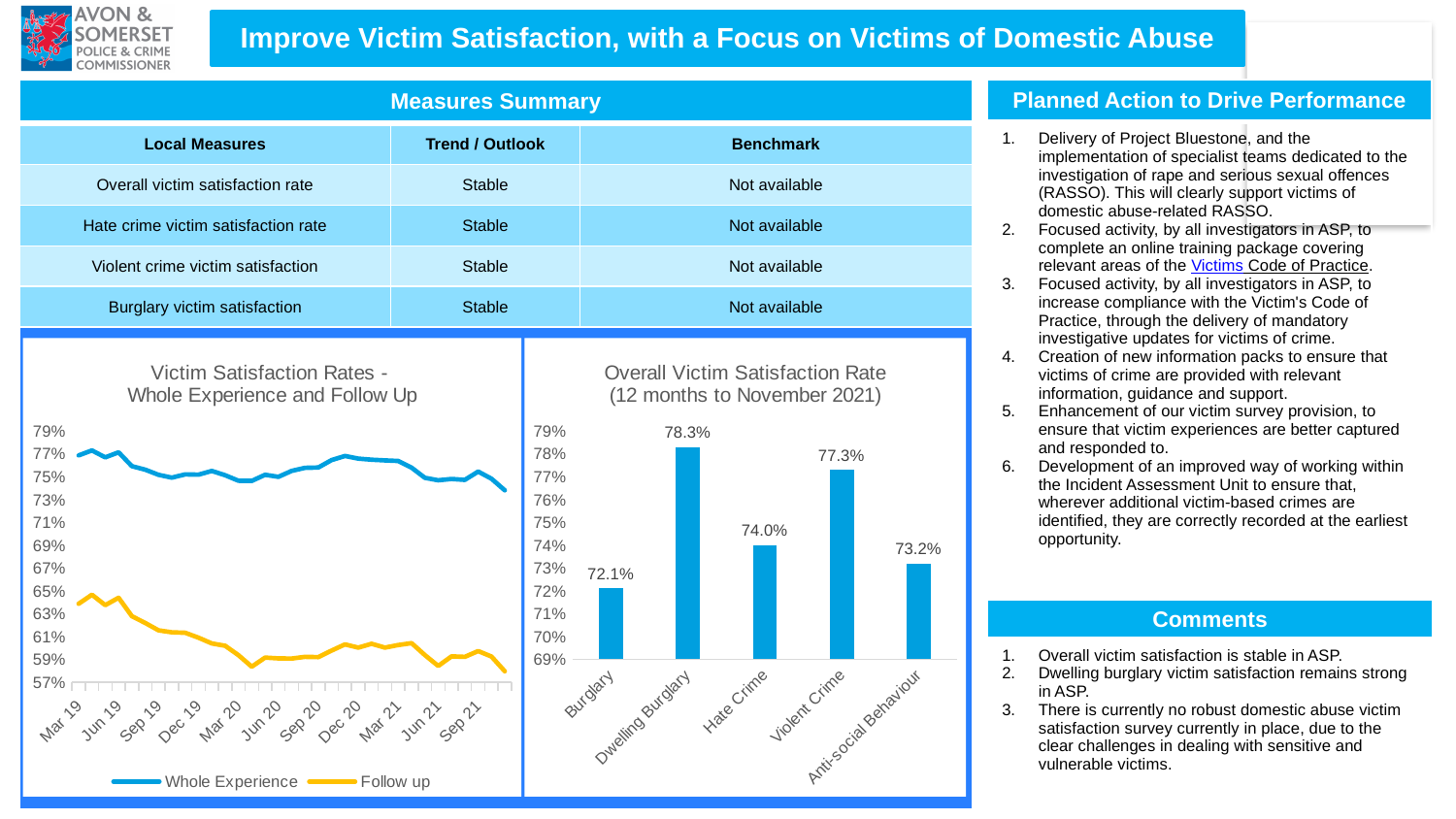
In the 'Overall Victim Satisfaction Rate (12 months to November 2021)' chart, what is the value for Dwelling Burglary? 78.3% What kind of chart is the 'Victim Satisfaction Rates - Whole Experience and Follow Up' chart? Line chart In the 'Overall Victim Satisfaction Rate (12 months to November 2021)' chart, what is the value for Anti-social Behaviour? 73.2% In the 'Overall Victim Satisfaction Rate (12 months to November 2021)' chart, what is the difference between the Violent Crime and Hate Crime values? 3.3% In the 'Overall Victim Satisfaction Rate (12 months to November 2021)' chart, which category has the lowest satisfaction rate? Burglary In the 'Victim Satisfaction Rates - Whole Experience and Follow Up' chart, is the Follow up value for Sep 21 greater or less than 65%? less In the 'Victim Satisfaction Rates - Whole Experience and Follow Up' chart, does the Follow up series generally rise or fall from Mar 19 to Sep 21? Fall In the 'Overall Victim Satisfaction Rate (12 months to November 2021)' chart, which category has the highest satisfaction rate? Dwelling Burglary In the 'Overall Victim Satisfaction Rate (12 months to November 2021)' chart, which is larger: Hate Crime or Anti-social Behaviour? Hate Crime What kind of chart is the 'Overall Victim Satisfaction Rate (12 months to November 2021)' chart? Bar chart How many series does the legend of the 'Victim Satisfaction Rates - Whole Experience and Follow Up' chart list? 2 How many categories are shown in the 'Overall Victim Satisfaction Rate (12 months to November 2021)' chart? 5